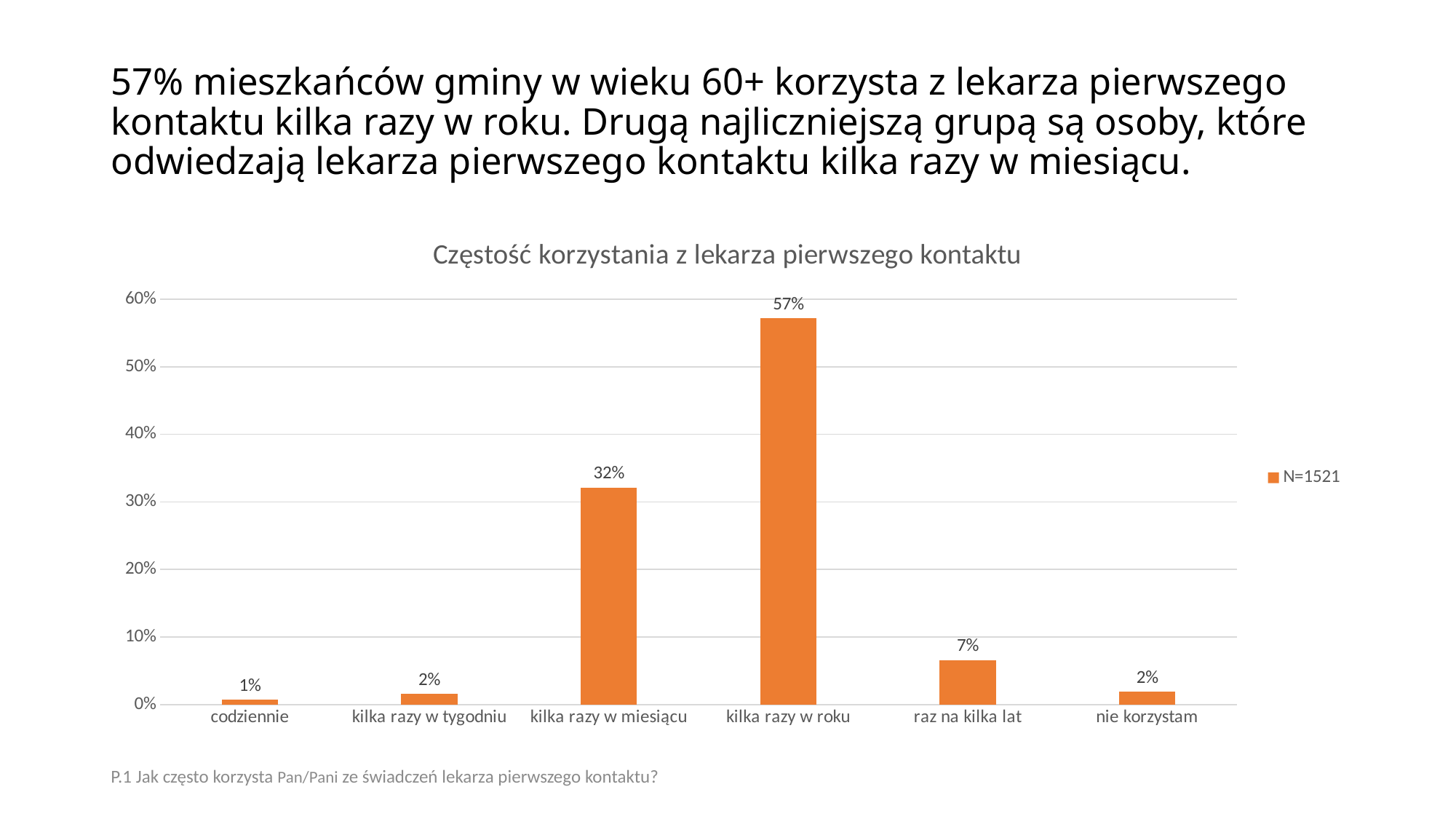
What kind of chart is shown on the slide? bar chart How many categories are shown on the x axis? 6 What is the value for "kilka razy w roku"? 57% Which is larger, the value for "raz na kilka lat" or the value for "nie korzystam"? raz na kilka lat What is the value for "raz na kilka lat"? 7% What is the difference between the values for "kilka razy w roku" and "kilka razy w miesiącu"? 25% Which category has the highest value? kilka razy w roku What is the value for "codziennie"? 1% Is the value for "kilka razy w miesiącu" greater or less than 30%? greater What is the legend entry shown for the series? N=1521 Which category has the lowest value? codziennie What is the value for "kilka razy w miesiącu"? 32%